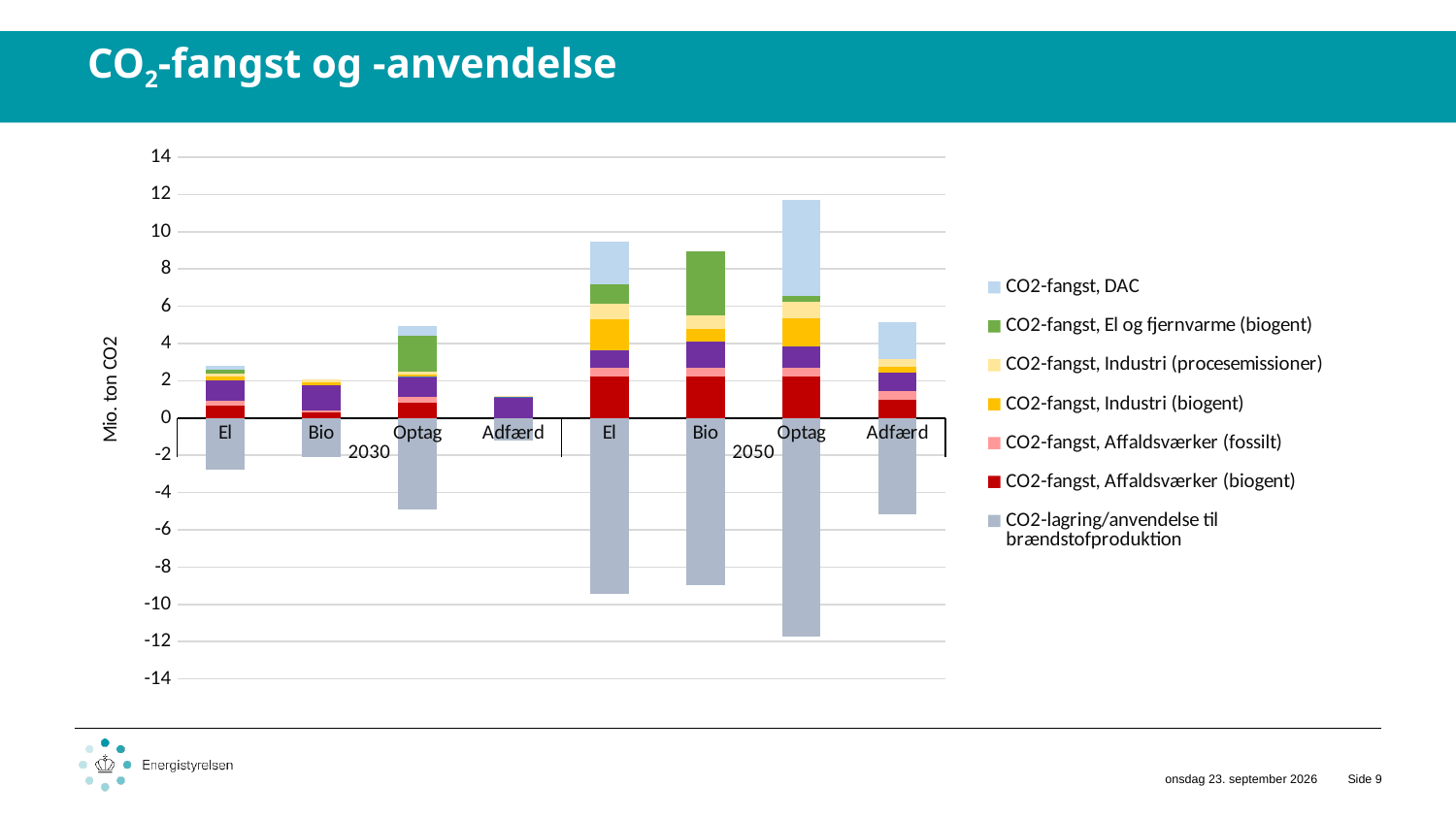
Is the top of the positive stack for El in 2050 greater or less than 8? greater Which has the larger positive stack: Adfærd in 2030 or Adfærd in 2050? Adfærd in 2050 What is the label on the vertical axis? Mio. ton CO2 What kind of chart is shown on the slide? Stacked bar chart Which has the larger positive stack: El in 2030 or El in 2050? El in 2050 Is the top of the positive stack for Adfærd in 2030 greater or less than 2? less How many series does the legend list? 7 What is the title of the slide's chart? CO2-fangst og -anvendelse Is the bottom of the negative bar (CO2-lagring/anvendelse til brændstofproduktion) for Optag in 2050 greater or less than -10? less Which bar has the tallest positive stack? Optag (2050) How many bars (category positions) are plotted along the x axis? 8